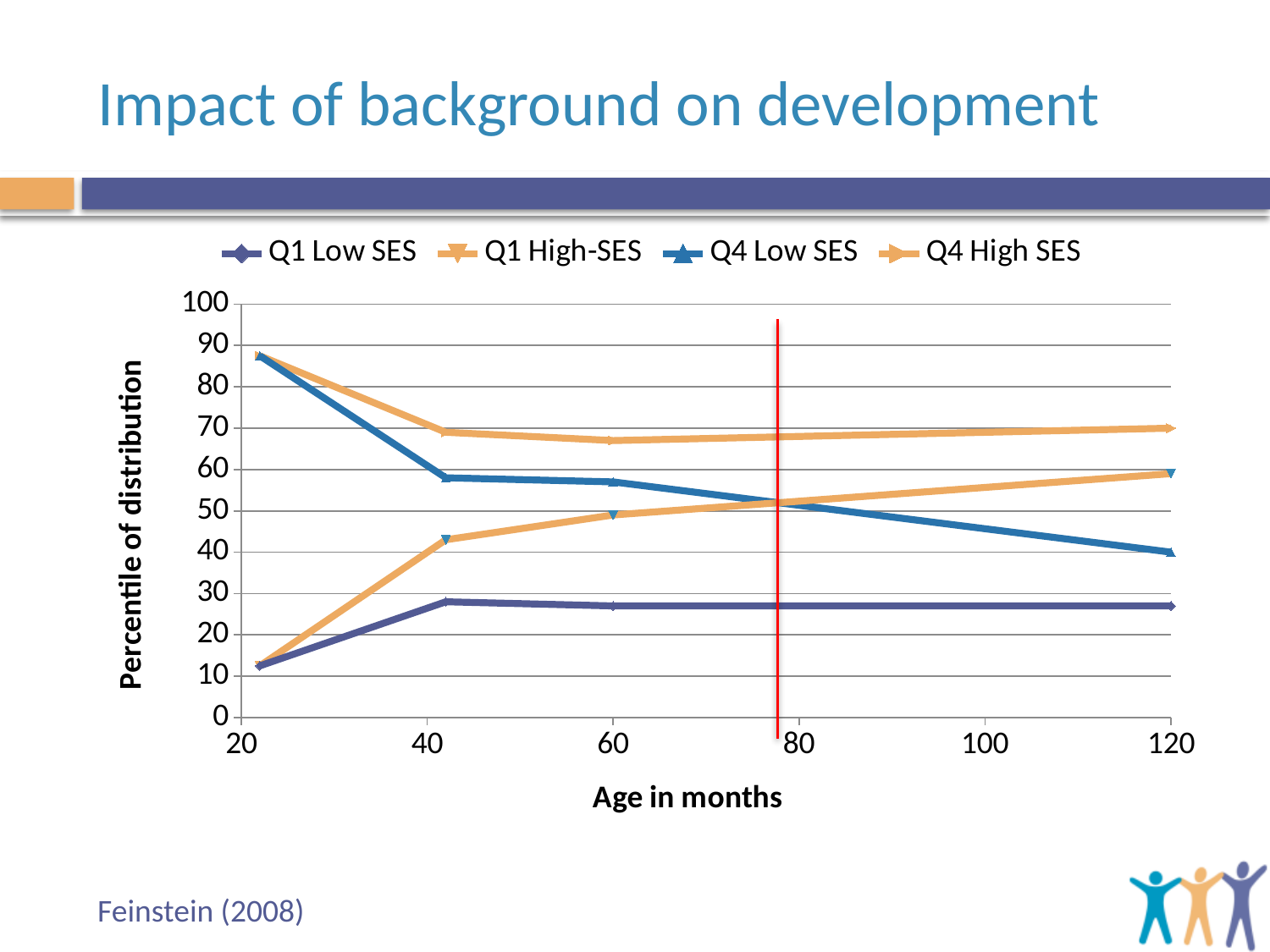
Does the Q4 Low SES line rise or fall as age in months increases? falls Is the value for Q4 High SES at 120 months greater or less than 60? greater How many series does the legend list? 4 At 120 months, which is larger: Q1 High-SES or Q4 Low SES? Q1 High-SES Is the value for Q1 High-SES at 60 months greater or less than 40? greater What kind of chart is shown on the slide? line chart Is the value for Q1 Low SES at 120 months greater or less than 30? less Does the Q1 High-SES line rise or fall as age in months increases? rises Which series has the highest value at 120 months? Q4 High SES What is the title of the x axis? Age in months What is the title of the y axis? Percentile of distribution